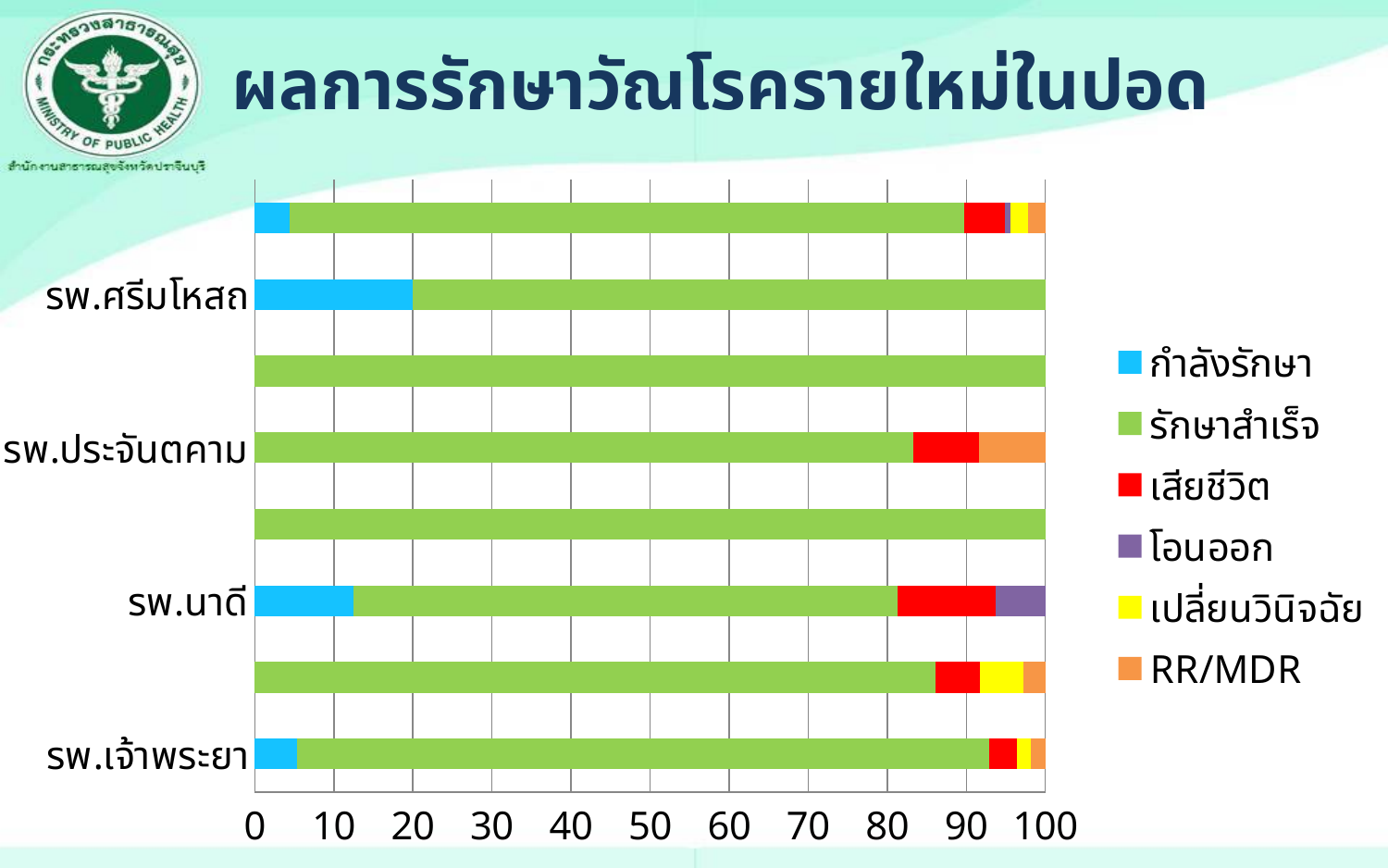
What is the title of the slide? ผลการรักษาวัณโรครายใหม่ในปอด What kind of chart is shown on the slide? bar chart What is the value of กำลังรักษา for รพ.ศรีมโหสถ? 20 How many bars are plotted in the chart? 8 Is the value of รักษาสำเร็จ for รพ.ประจันตคาม greater or less than 90? less Is the value of กำลังรักษา for รพ.เจ้าพระยา greater or less than 10? less How many series does the legend list? 6 Which has the larger value of กำลังรักษา, รพ.ศรีมโหสถ or รพ.เจ้าพระยา? รพ.ศรีมโหสถ Is the value of กำลังรักษา for รพ.นาดี greater or less than 20? less Which series is shown in purple in the legend? โอนออก Which has the larger value of เสียชีวิต, รพ.นาดี or รพ.เจ้าพระยา? รพ.นาดี Which series is shown in orange in the legend? RR/MDR